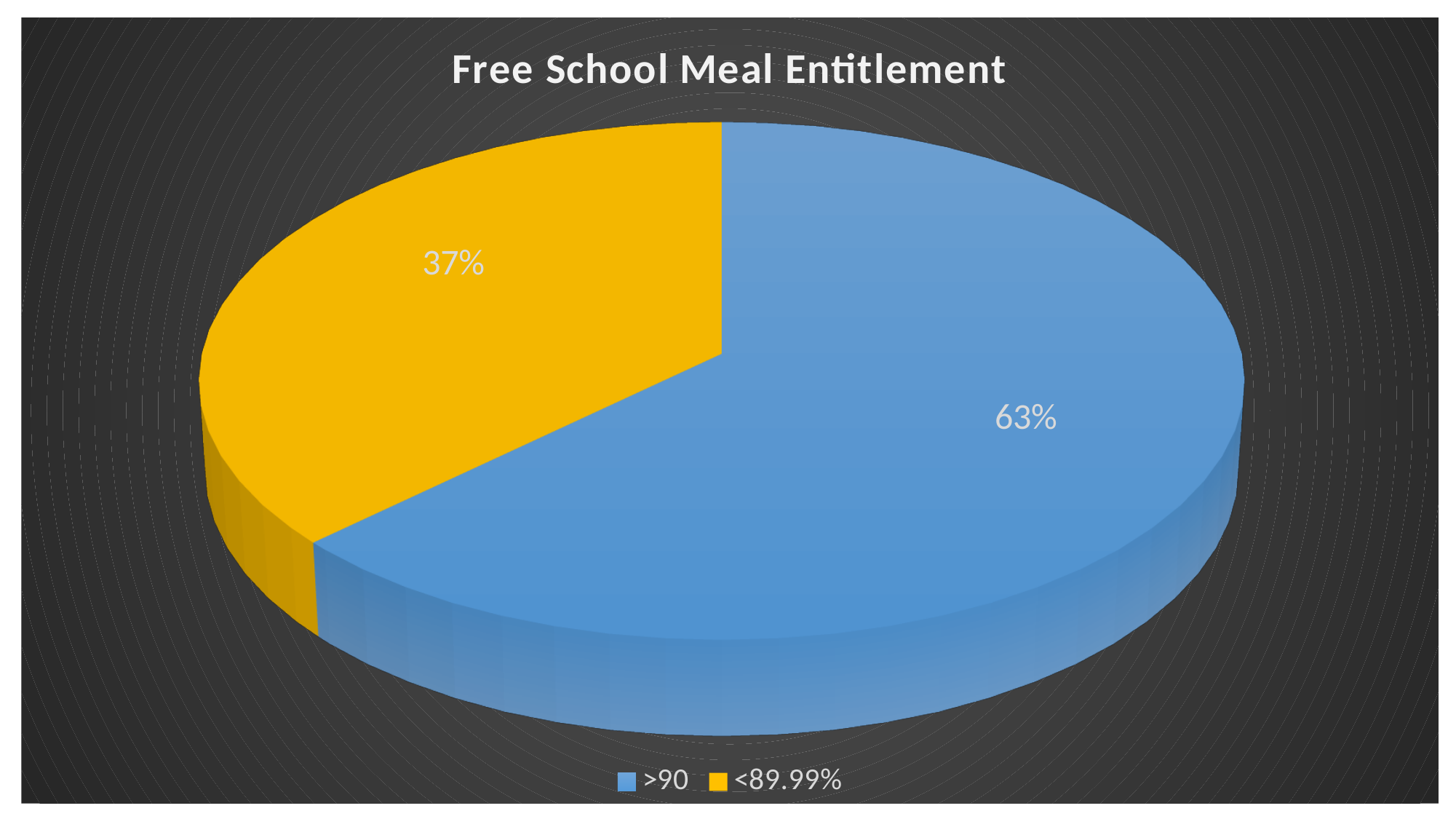
How many entries does the legend list? 2 What share of the pie does the ">90" slice represent? 63% What kind of chart is shown on the slide? pie chart What is the title of the chart? Free School Meal Entitlement What share of the pie does the "<89.99%" slice represent? 37% How many slices does the pie chart have? 2 What is the difference in percentage points between the ">90" slice and the "<89.99%" slice? 26 What colour is the "<89.99%" slice? yellow Which slice is the smallest in the pie chart? <89.99% Which slice is the largest in the pie chart? >90 Which is larger, the ">90" slice or the "<89.99%" slice? >90